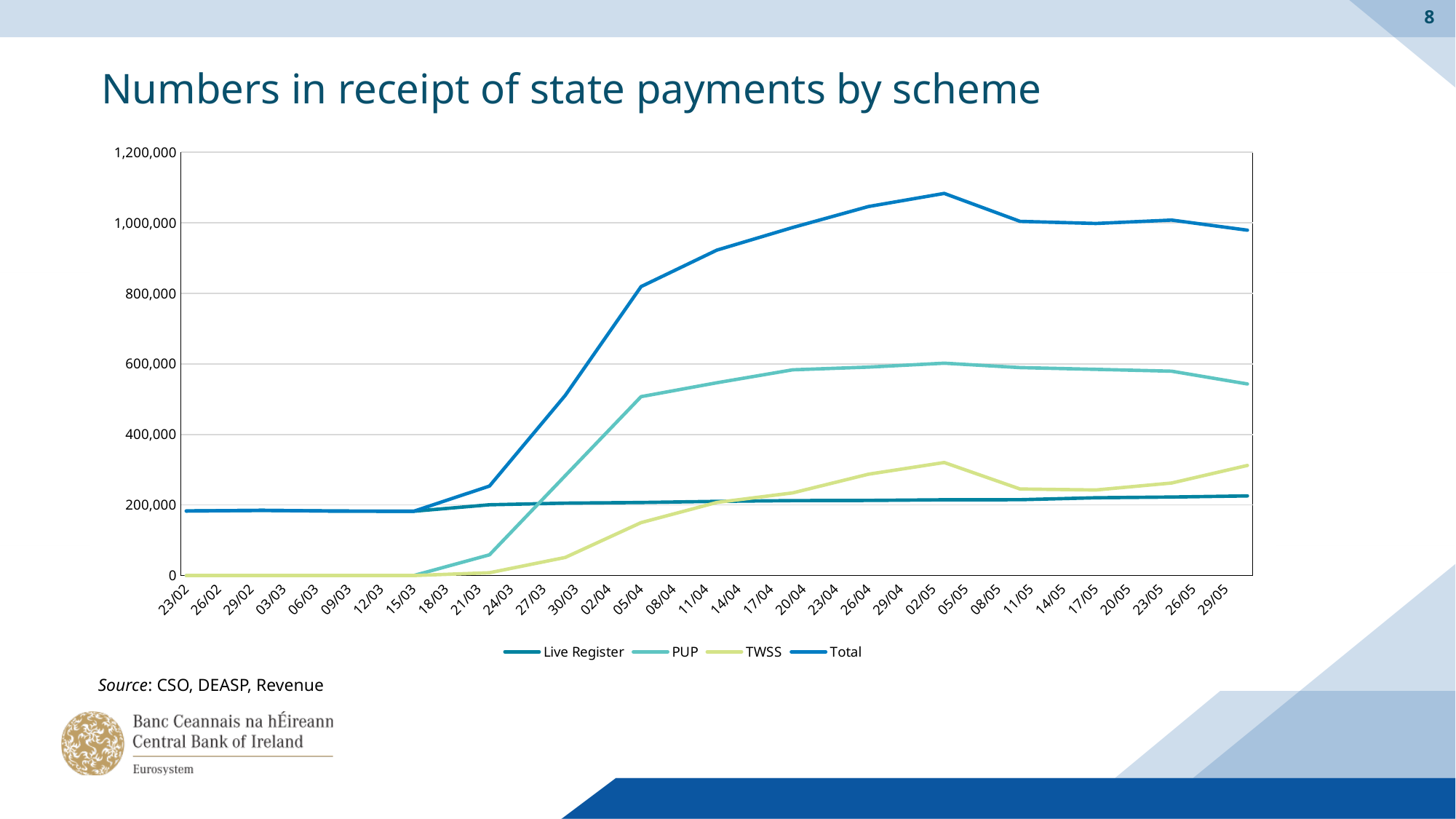
Is the value for PUP on 29/05 greater or less than 600,000? less Which series are listed in the legend? Live Register, PUP, TWSS, Total Is the value for Live Register on 23/02 greater or less than 200,000? less Which series has the highest value on 29/05? Total How many series does the legend list? 4 On 05/04, which is larger, Total or PUP? Total On 29/05, which is larger, PUP or TWSS? PUP Is the value for TWSS on 02/05 greater or less than 200,000? greater What is the title of the chart? Numbers in receipt of state payments by scheme What kind of chart is shown on the slide? line chart Does the Total series rise or fall between 23/02 and 05/04? rise